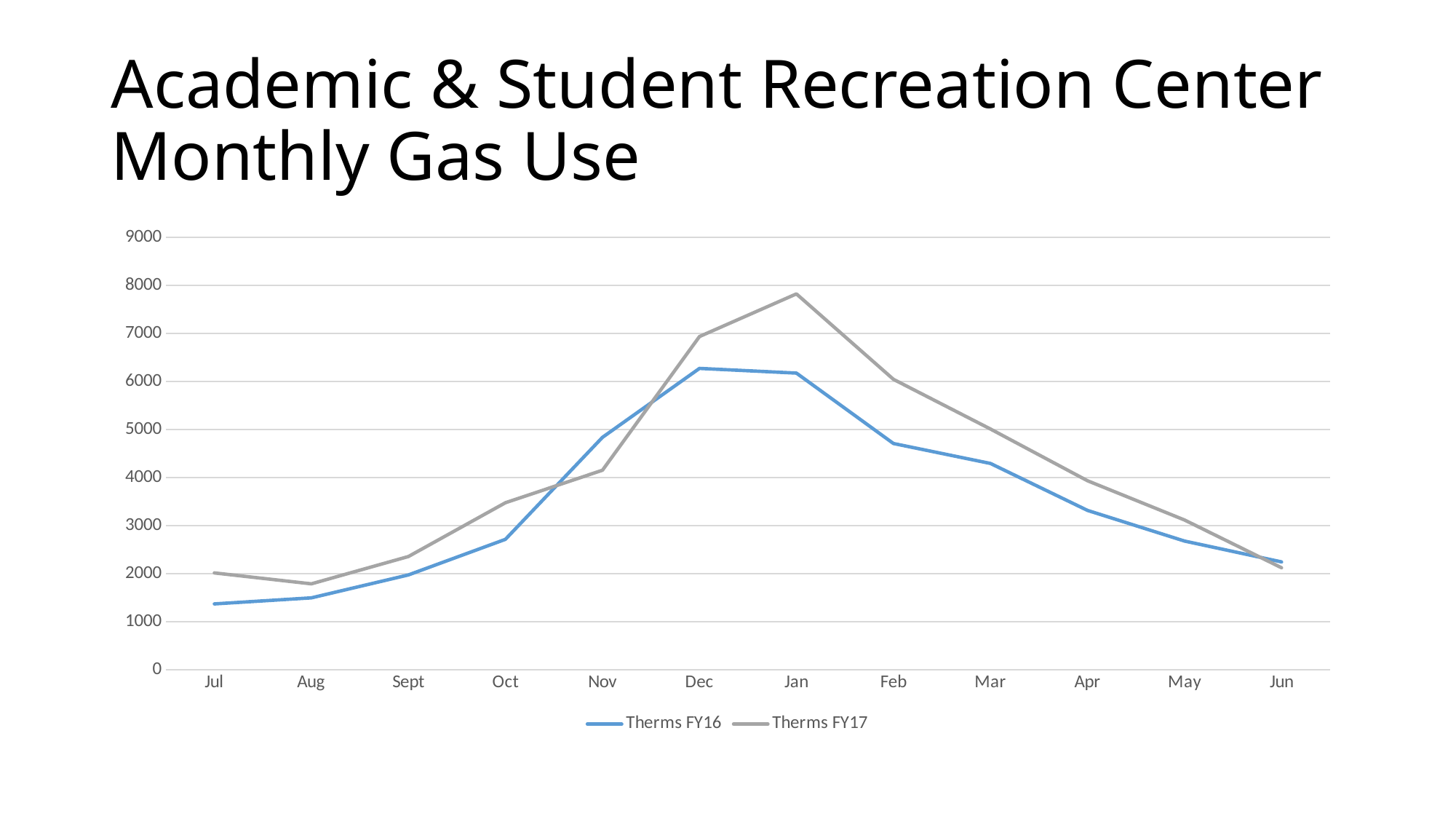
Is the Therms FY17 value for Oct greater or less than 3000? greater Does the Therms FY17 series rise or fall from Jan to Jun? fall How many series does the legend list? 2 Is the Therms FY16 value for Jul greater or less than 2000? less In which month is the Therms FY17 series at its lowest value? Aug Is the Therms FY17 value for Jan greater or less than 7000? greater In which month does the Therms FY17 series reach its highest value? Jan In Jan, which series has the larger value, Therms FY16 or Therms FY17? Therms FY17 How many months are plotted along the x axis? 12 What kind of chart is shown on the slide? line chart In Nov, which series has the larger value, Therms FY16 or Therms FY17? Therms FY16